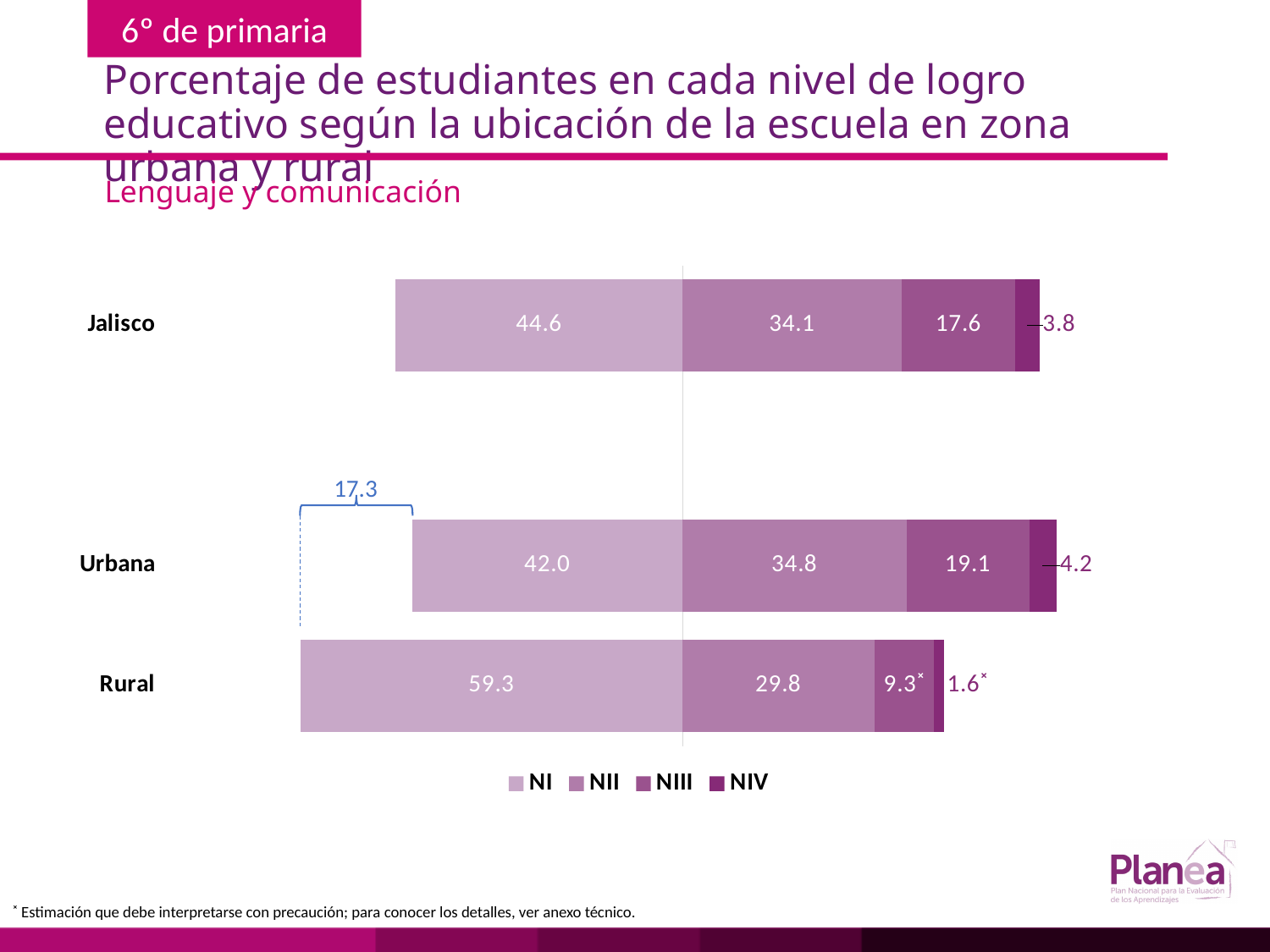
Which category has the lowest NIV value? Rural Which category has the highest NI value? Rural Which is larger, the NIII value for Urbana or for Jalisco? Urbana How many categories are shown on the chart? 3 What is the total of the stacked bar for Rural? 100.0 What is the NIII value for Urbana? 19.1 What is the difference between the NI values for Rural and Urbana? 17.3 What percentage of Rural students are at level NI? 59.3 How many series does the legend list? 4 What kind of chart is shown on the slide? Stacked bar chart What is the NII value for Rural? 29.8 What is the NIV value for Jalisco? 3.8